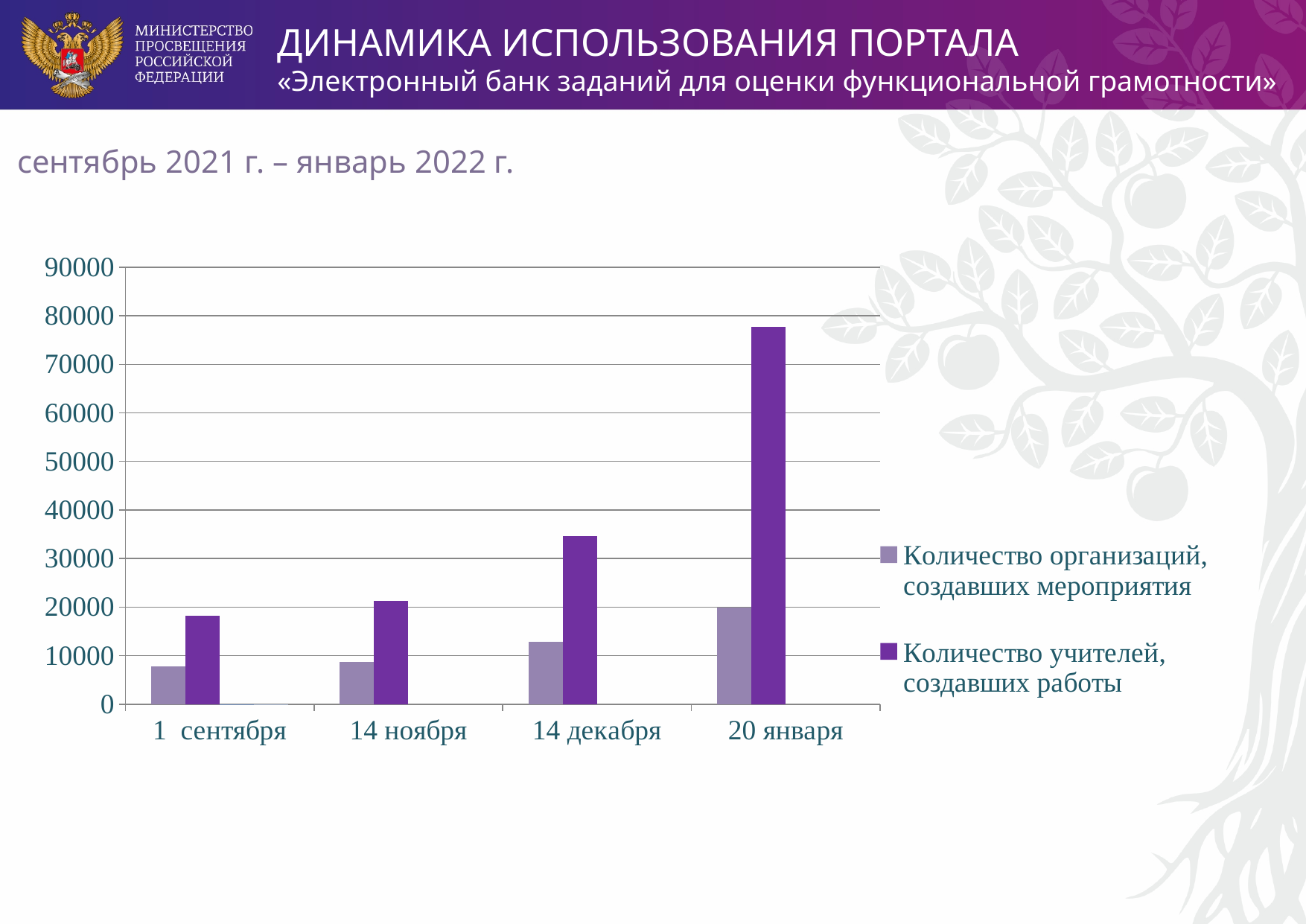
How many series does the legend list? 2 Is the value for «Количество организаций, создавших мероприятия» on 1 сентября greater or less than 10000? less Which colour represents «Количество учителей, создавших работы» in the legend? dark purple On 20 января, which is larger: «Количество учителей, создавших работы» or «Количество организаций, создавших мероприятия»? Количество учителей, создавших работы What kind of chart is shown on the slide? bar chart How many dates are shown along the x axis? 4 Is the value for «Количество учителей, создавших работы» on 14 декабря greater or less than 30000? greater On which date is the value for «Количество учителей, создавших работы» highest? 20 января On which date is the value for «Количество организаций, создавших мероприятия» lowest? 1 сентября Is the value for «Количество учителей, создавших работы» on 20 января greater or less than 70000? greater Do the values for «Количество учителей, создавших работы» rise or fall from 1 сентября to 20 января? rise